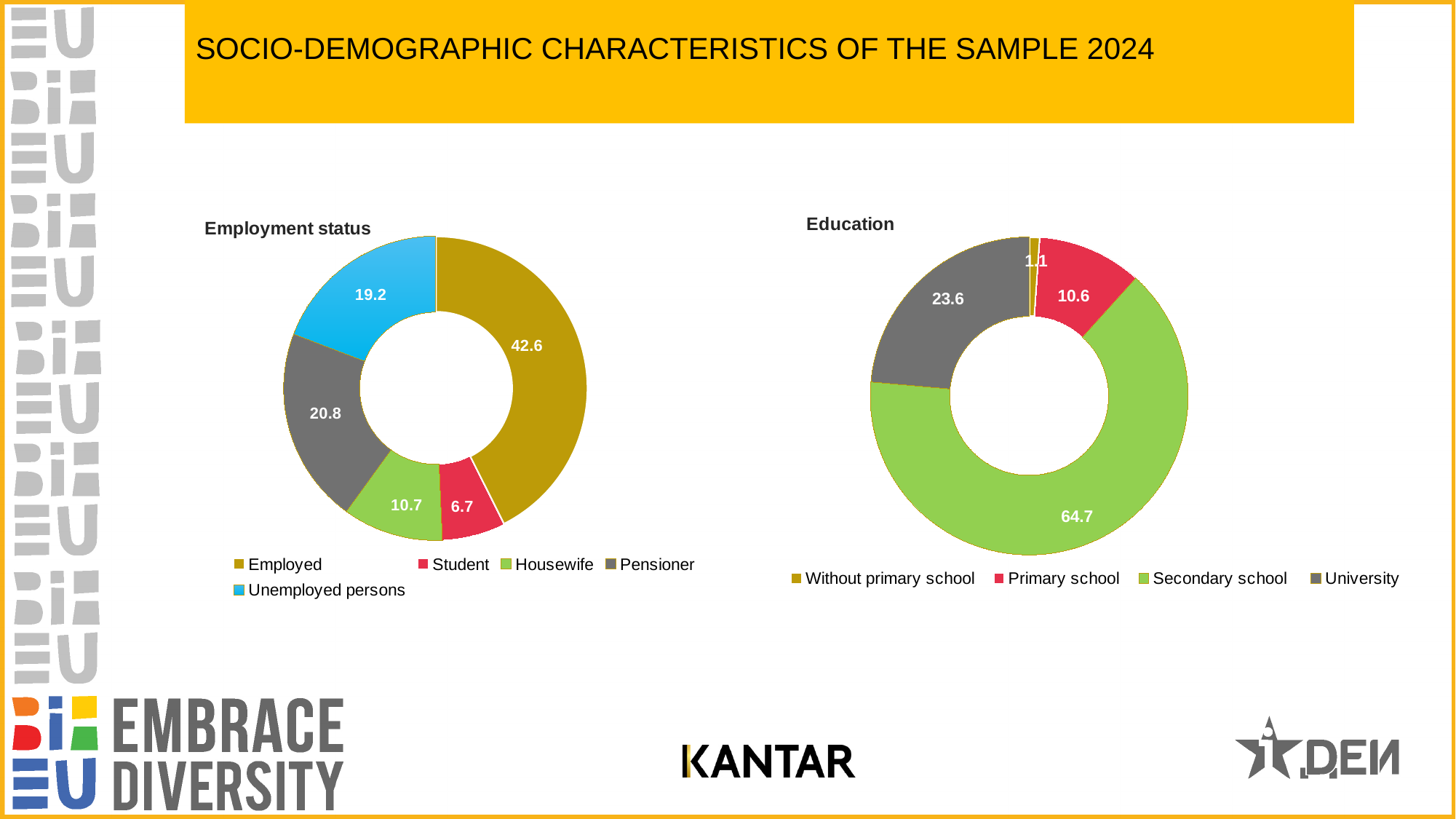
In the Employment status chart, which category has the largest share? Employed In the Education chart, what is the difference between the values for Secondary school and University? 41.1 What kind of chart is the Education chart? Doughnut chart In the Education chart, what is the value for Secondary school? 64.7 In the Employment status chart, what is the value for Unemployed persons? 19.2 In the Employment status chart, how many categories are shown? 5 In the Education chart, what is the value for Without primary school? 1.1 In the Education chart, which is larger, University or Primary school? University In the Education chart, how many entries does the legend list? 4 In the Employment status chart, which category has the smallest share? Student In the Employment status chart, what is the value for Employed? 42.6 In the Employment status chart, what is the difference between the values for Pensioner and Housewife? 10.1